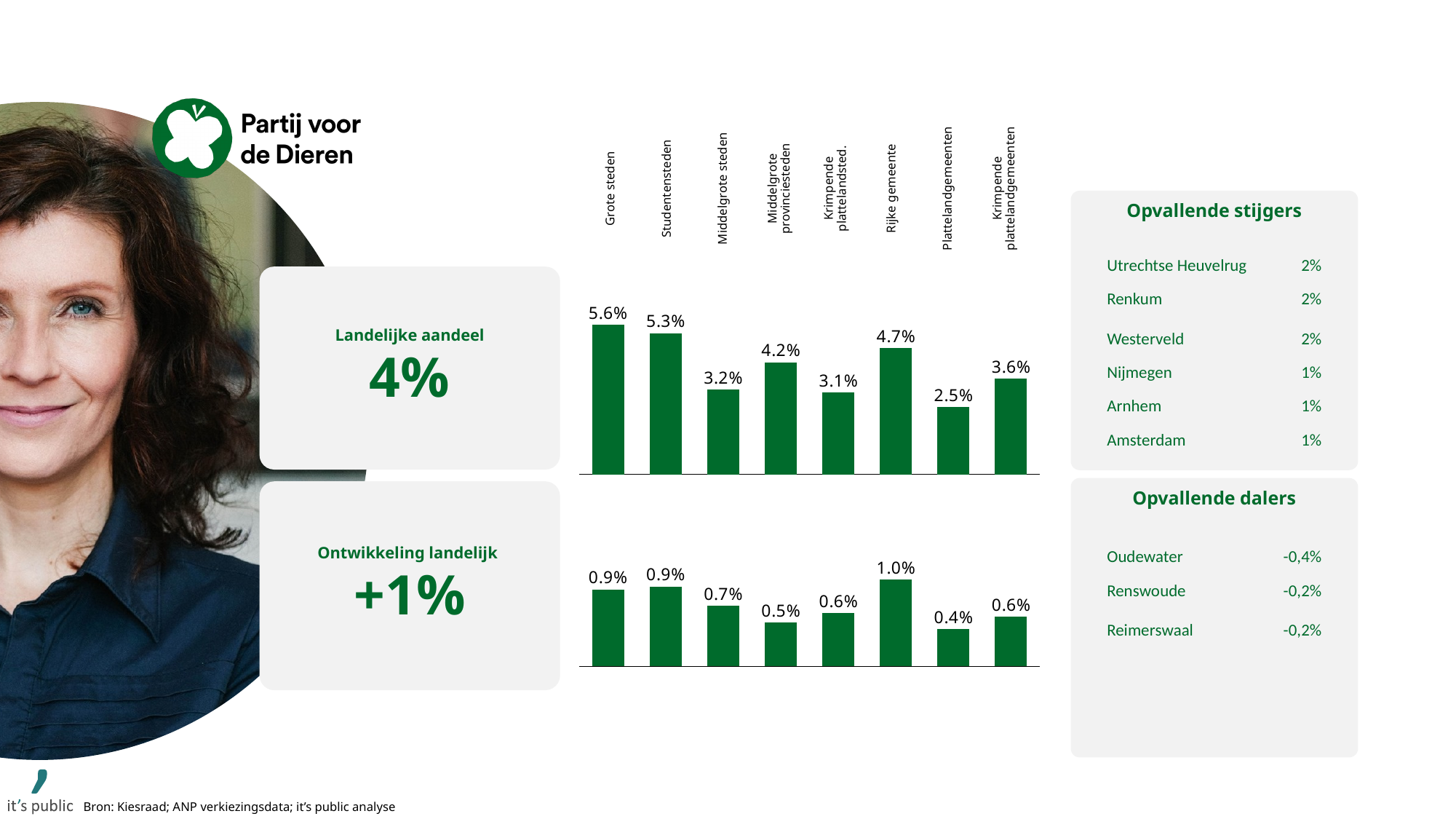
How many categories are shown in the top chart (Landelijke aandeel)? 8 In the top chart (Landelijke aandeel), which category has the lowest value? Plattelandgemeenten In the top chart (Landelijke aandeel), what is the value for Rijke gemeente? 4.7% What kind of chart is the top chart (Landelijke aandeel)? Bar chart In the top chart (Landelijke aandeel), which category has the highest value? Grote steden In the bottom chart (Ontwikkeling landelijk), what is the value for Rijke gemeente? 1.0% In the top chart (Landelijke aandeel), what is the value for Grote steden? 5.6% In the top chart (Landelijke aandeel), which is larger: Middelgrote provinciesteden or Krimpende plattelandgemeenten? Middelgrote provinciesteden In the top chart (Landelijke aandeel), what is the difference between Grote steden and Plattelandgemeenten? 3.1% In the bottom chart (Ontwikkeling landelijk), which category has the highest value? Rijke gemeente In the bottom chart (Ontwikkeling landelijk), what is the value for Plattelandgemeenten? 0.4% In the bottom chart (Ontwikkeling landelijk), what is the difference between Grote steden and Middelgrote provinciesteden? 0.4%